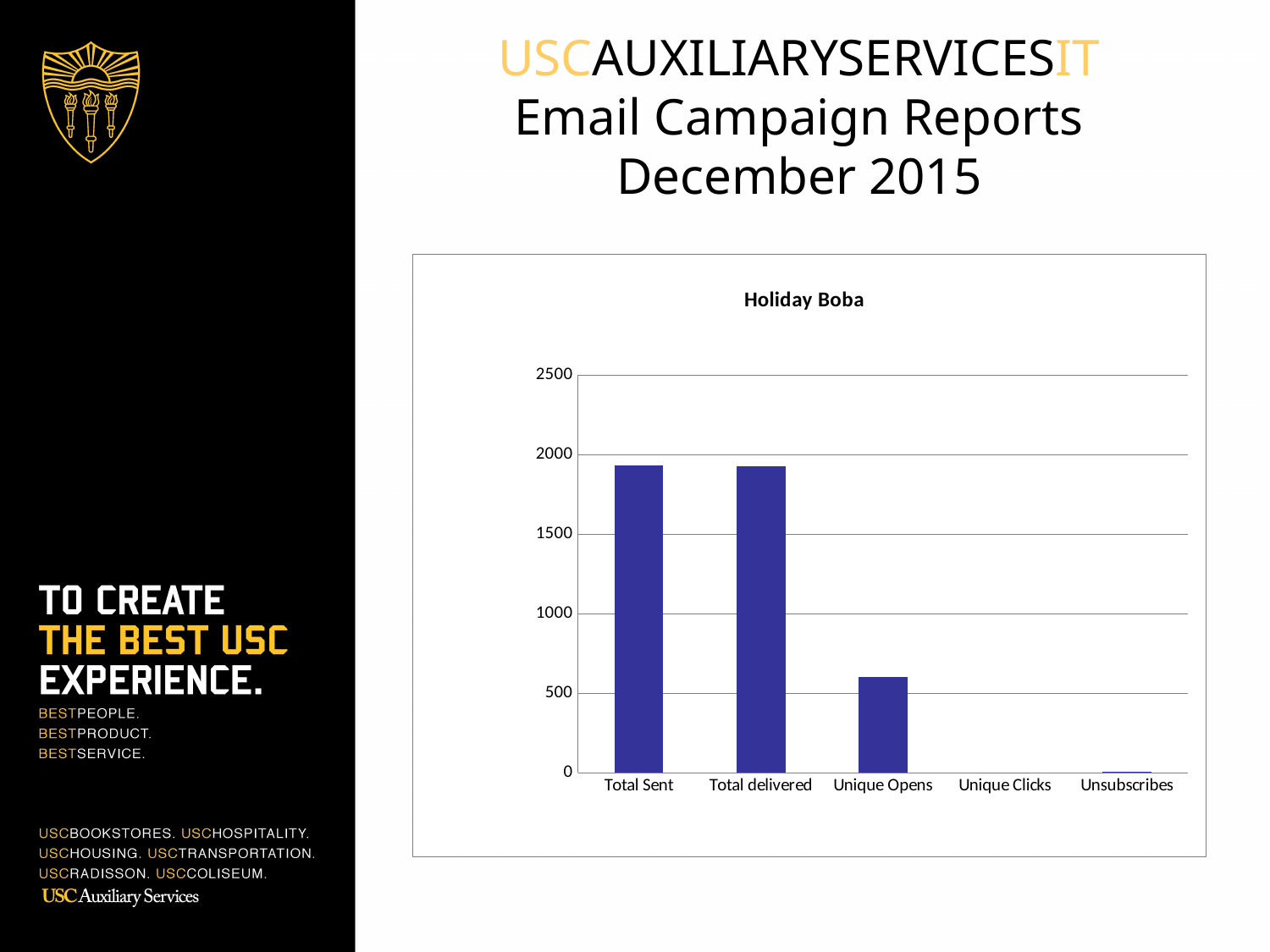
Is the value for Unique Opens greater or less than 500? greater How many categories are shown on the x axis of the chart? 5 What kind of chart is shown on the slide? bar chart Do the values generally rise or fall moving from left to right along the x axis? fall Is the value for Unique Opens greater or less than 1000? less Which is larger, the value for Unique Opens or the value for Unsubscribes? Unique Opens What is the title of the chart? Holiday Boba Is the value for Total Sent greater or less than 1500? greater What is the highest value shown on the y axis of the chart? 2500 Which is larger, the value for Total Sent or the value for Unique Opens? Total Sent